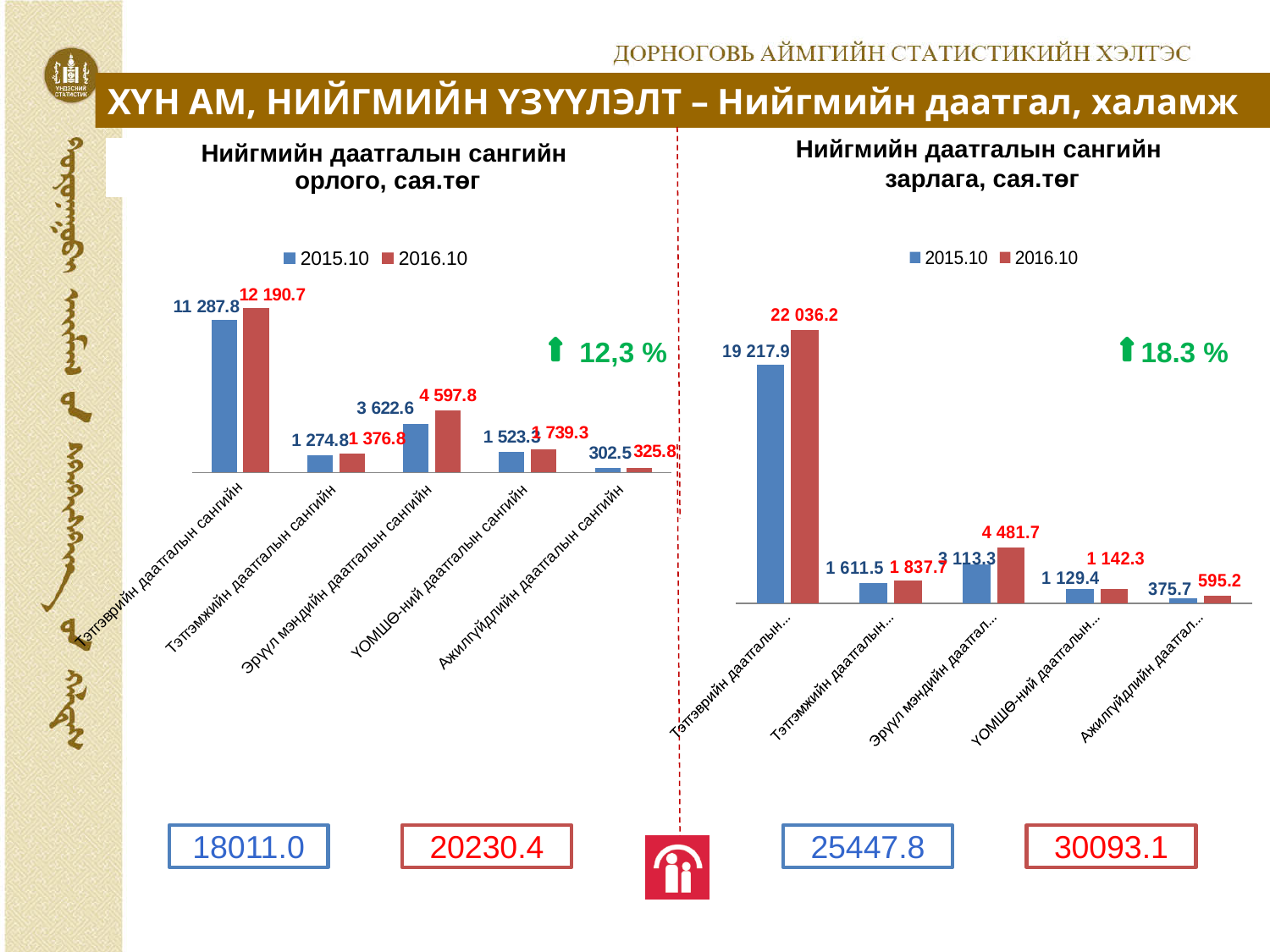
In the left chart (Нийгмийн даатгалын сангийн орлого), what is the 2016.10 value for Тэтгэврийн даатгалын сангийн? 12 190.7 What type of chart is the left chart (Нийгмийн даатгалын сангийн орлого)? Bar chart In the right chart (Нийгмийн даатгалын сангийн зарлага), what is the 2015.10 value for Ажилгүйдлийн даатгал? 375.7 In the right chart (Нийгмийн даатгалын сангийн зарлага), what is the difference between the 2016.10 and 2015.10 values for Эрүүл мэндийн даатгал? 1 368.4 In the right chart (Нийгмийн даатгалын сангийн зарлага), what is the 2016.10 value for Тэтгэврийн даатгалын? 22 036.2 How many series does the legend of the right chart (Нийгмийн даатгалын сангийн зарлага) list? 2 In the left chart (Нийгмийн даатгалын сангийн орлого), what is the difference between the 2016.10 and 2015.10 values for Эрүүл мэндийн даатгалын сангийн? 975.2 In the left chart (Нийгмийн даатгалын сангийн орлого), what is the 2015.10 value for Эрүүл мэндийн даатгалын сангийн? 3 622.6 In the right chart (Нийгмийн даатгалын сангийн зарлага), which is larger for Тэтгэмжийн даатгалын: the 2015.10 value or the 2016.10 value? 2016.10 In the right chart (Нийгмийн даатгалын сангийн зарлага), which category has the highest 2015.10 value? Тэтгэврийн даатгалын In the left chart (Нийгмийн даатгалын сангийн орлого), which category has the lowest 2016.10 value? Ажилгүйдлийн даатгалын сангийн In the left chart (Нийгмийн даатгалын сангийн орлого), how many categories are shown on the x axis? 5